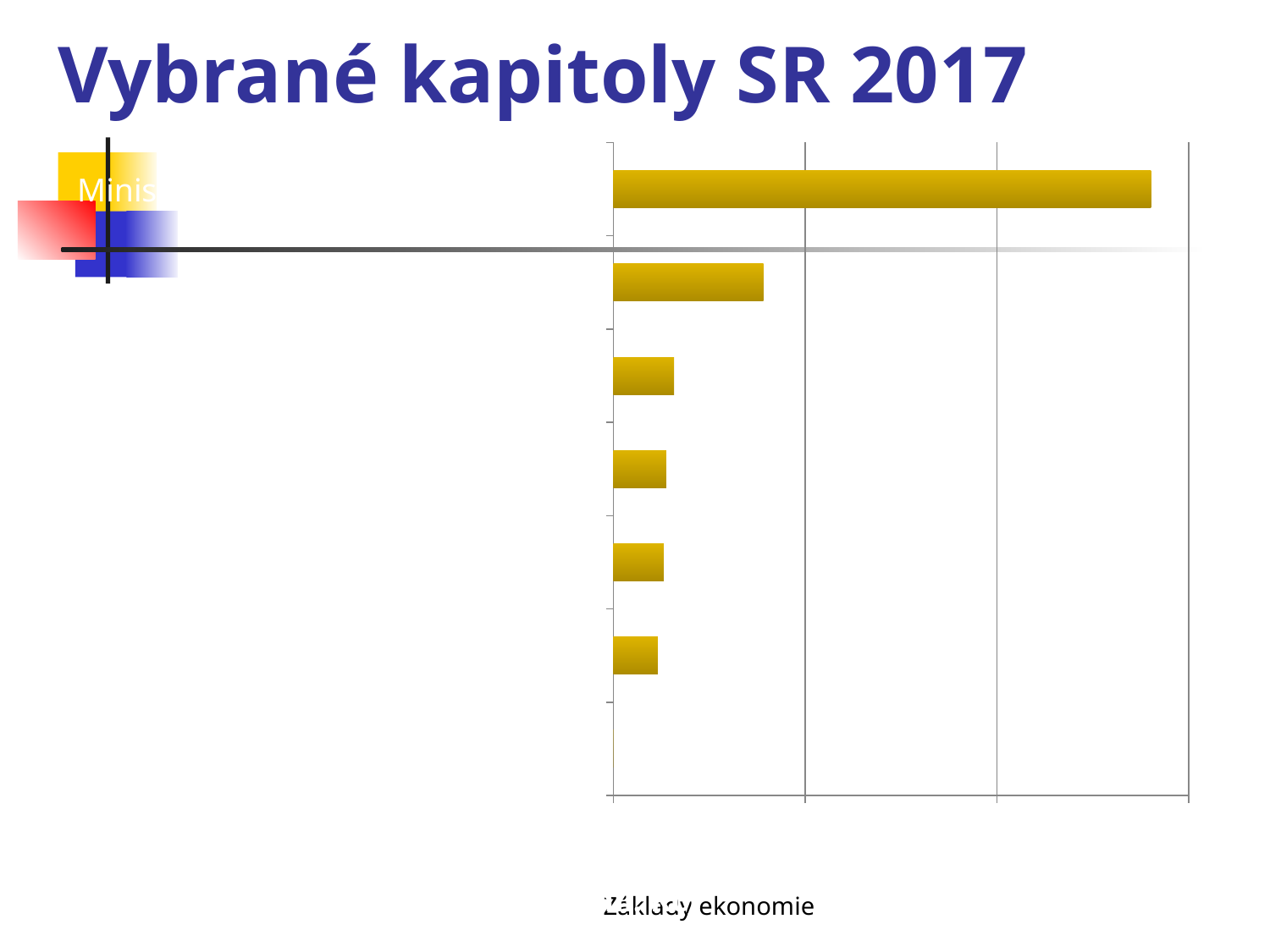
Are the bars in the chart horizontal or vertical? horizontal How many bars (categories) does the chart show? 7 What colour are the bars in the chart? gold/yellow Which is longer, the second bar from the top or the third bar from the top? the second bar from the top Which bar in the chart is the longest? the top bar What is the title of the slide containing the chart? Vybrané kapitoly SR 2017 Which bar in the chart is the shortest? the bottom bar What kind of chart is shown on the slide? bar chart